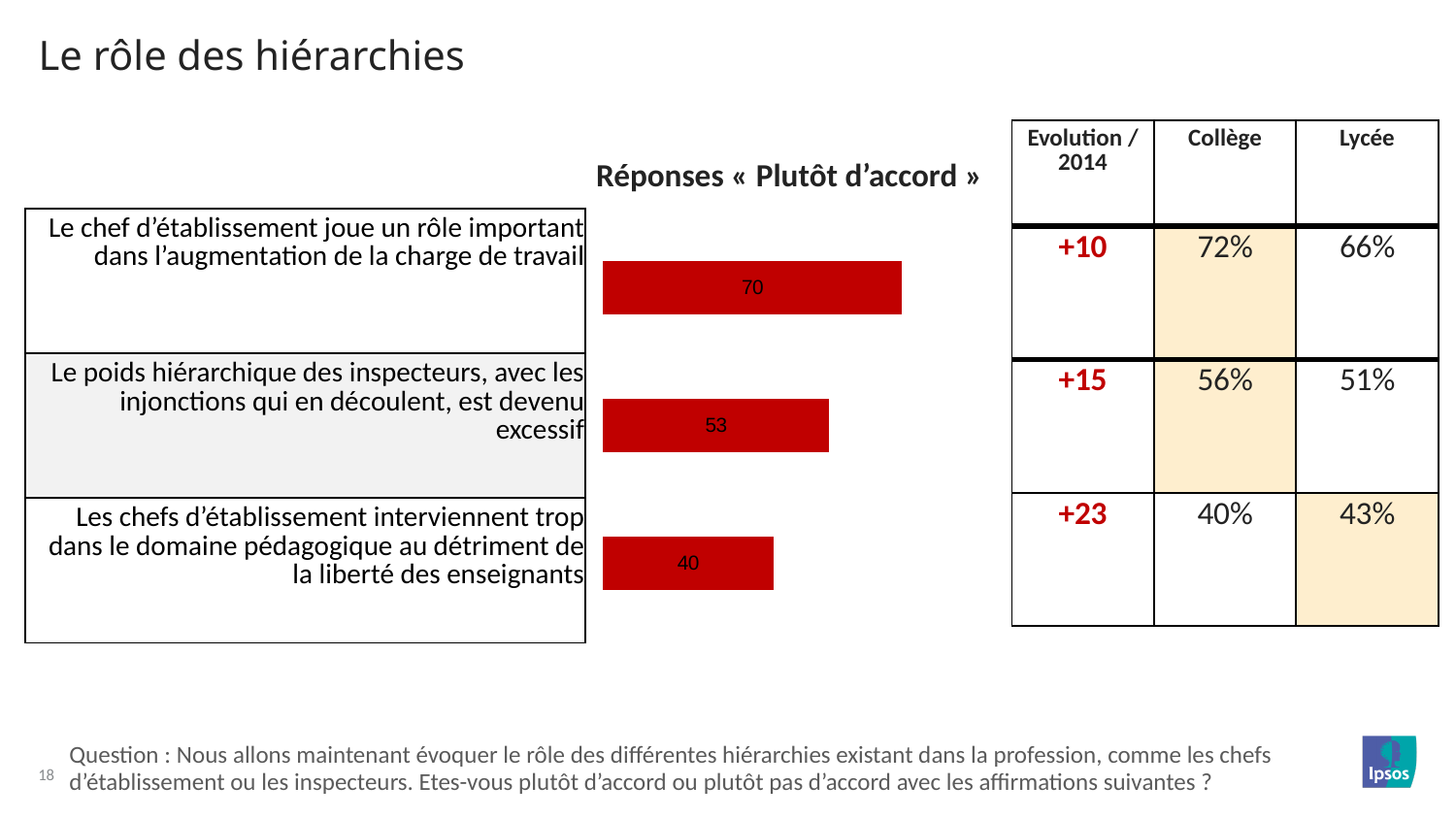
How many statements (categories) are plotted in the chart? 3 What is the value for "Le chef d'établissement joue un rôle important dans l'augmentation de la charge de travail"? 70 What is the title of the chart? Réponses « Plutôt d'accord » What is the value for "Les chefs d'établissement interviennent trop dans le domaine pédagogique au détriment de la liberté des enseignants"? 40 Which statement has the lowest value in the chart? Les chefs d'établissement interviennent trop dans le domaine pédagogique au détriment de la liberté des enseignants What is the difference between the highest and lowest values in the chart? 30 What kind of chart is shown on the slide? bar chart What is the value for "Le poids hiérarchique des inspecteurs, avec les injonctions qui en découlent, est devenu excessif"? 53 Which is larger: the value for the statement about inspecteurs' hierarchical weight or the value for the statement about chefs d'établissement intervening in pedagogy? the statement about inspecteurs' hierarchical weight What is the difference between the value for the statement about the chef d'établissement increasing workload and the statement about inspecteurs' hierarchical weight? 17 What colour are the bars in the chart? red Which statement has the highest value in the chart? Le chef d'établissement joue un rôle important dans l'augmentation de la charge de travail